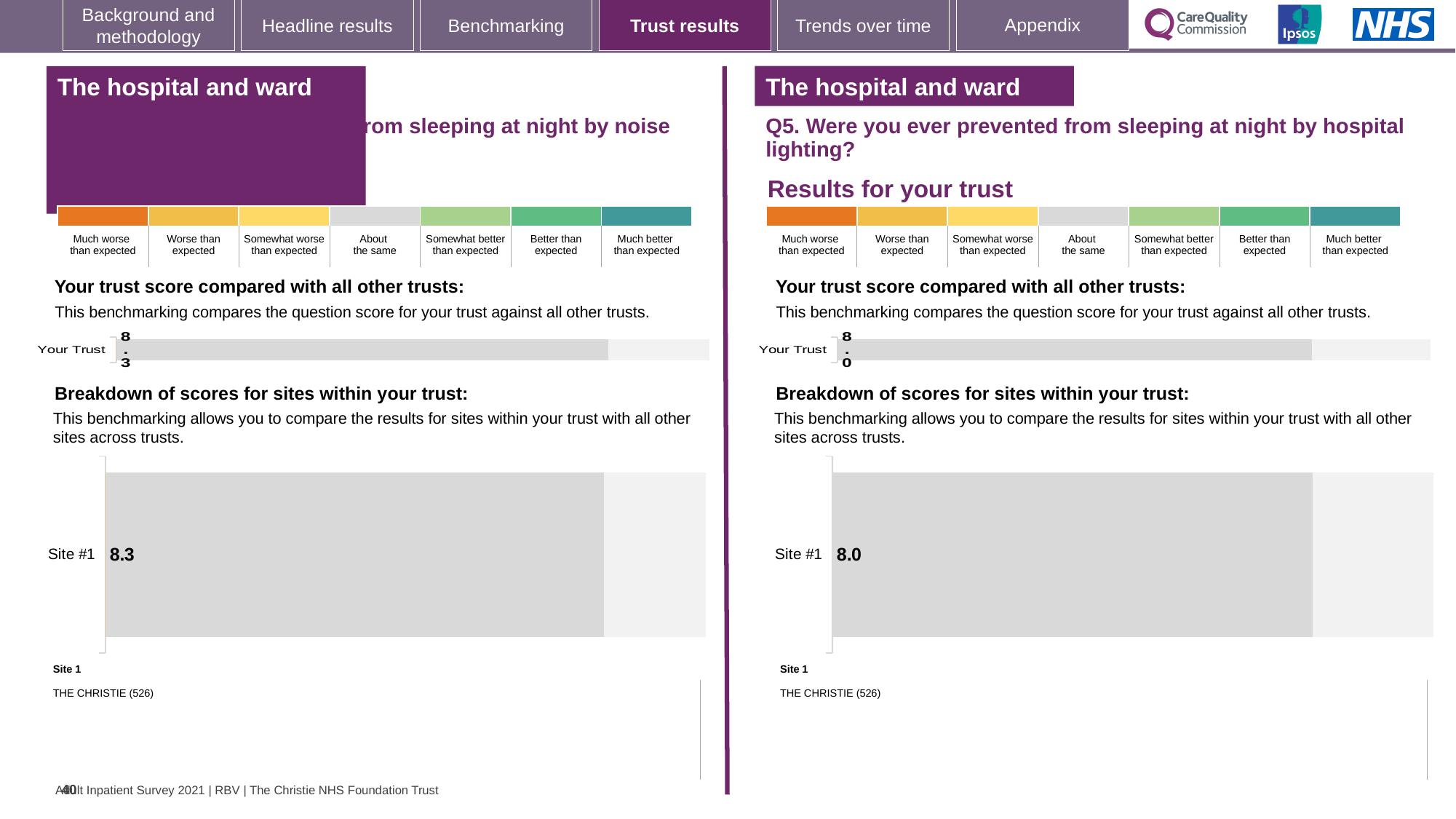
How many sites are shown in the right-hand 'Breakdown of scores for sites within your trust' chart (Q5, hospital lighting)? 1 On the left-hand side of the slide (the question about noise), what is the score shown for Your Trust? 8.3 How many sites are shown in the left-hand 'Breakdown of scores for sites within your trust' chart (noise question)? 1 In the left-hand 'Breakdown of scores for sites within your trust' chart (noise question), what is the score for Site #1? 8.3 What type of chart is used to show the Site #1 score in the right-hand 'Breakdown of scores for sites within your trust' section? Bar chart What is the question number and topic of the right-hand chart on the slide? Q5. Were you ever prevented from sleeping at night by hospital lighting? On the right-hand side of the slide (Q5, hospital lighting), what is the score shown for Your Trust? 8.0 Which site name is listed under 'Site 1' beneath the right-hand breakdown chart? THE CHRISTIE (526) What is the difference between the Site #1 score in the left-hand chart (8.3) and the Site #1 score in the right-hand chart (8.0)? 0.3 Which is larger: the Site #1 score in the left-hand chart (noise) or the Site #1 score in the right-hand chart (Q5, hospital lighting)? Left-hand chart (noise), 8.3 In the right-hand 'Breakdown of scores for sites within your trust' chart (Q5, hospital lighting), what is the score for Site #1? 8.0